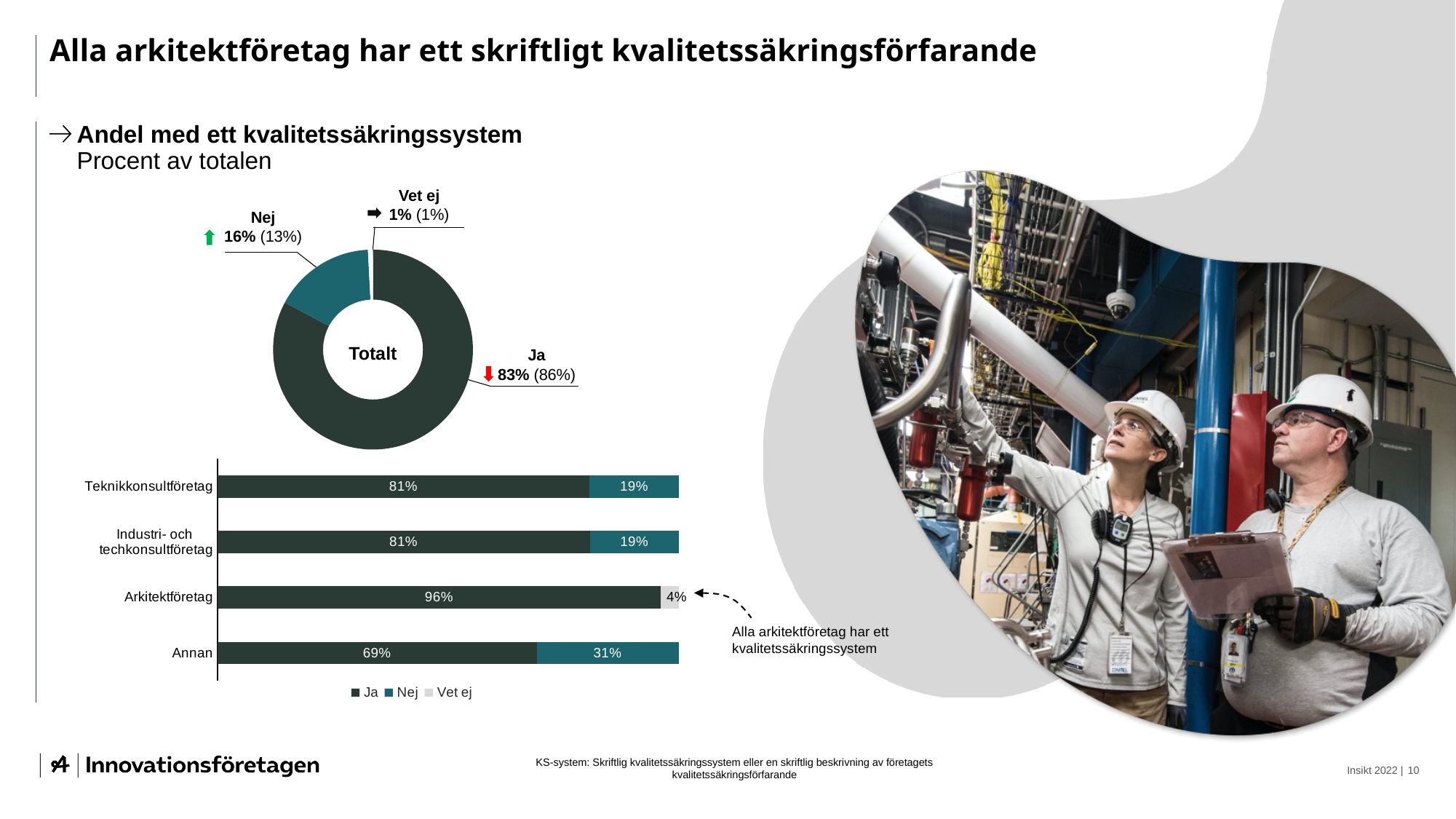
In the donut chart (Totalt), what share answered Ja? 83% What type of chart is the lower chart on the slide? Stacked bar chart In the donut chart (Totalt), what is the value shown in parentheses for Vet ej? 1% How many categories are shown in the bar chart by company type? 4 In the donut chart (Totalt), which category has the largest share? Ja How many series does the legend of the bar chart by company type list? 3 In the bar chart by company type, which category has the lowest Ja value? Annan In the bar chart by company type, what is the Ja value for Arkitektföretag? 96% In the bar chart by company type, which is larger: the Nej value for Teknikkonsultföretag or the Nej value for Annan? Annan In the donut chart (Totalt), what is the difference between the Ja share and the Nej share? 67% In the donut chart (Totalt), what share answered Nej? 16% In the bar chart by company type, what is the Nej value for Annan? 31%